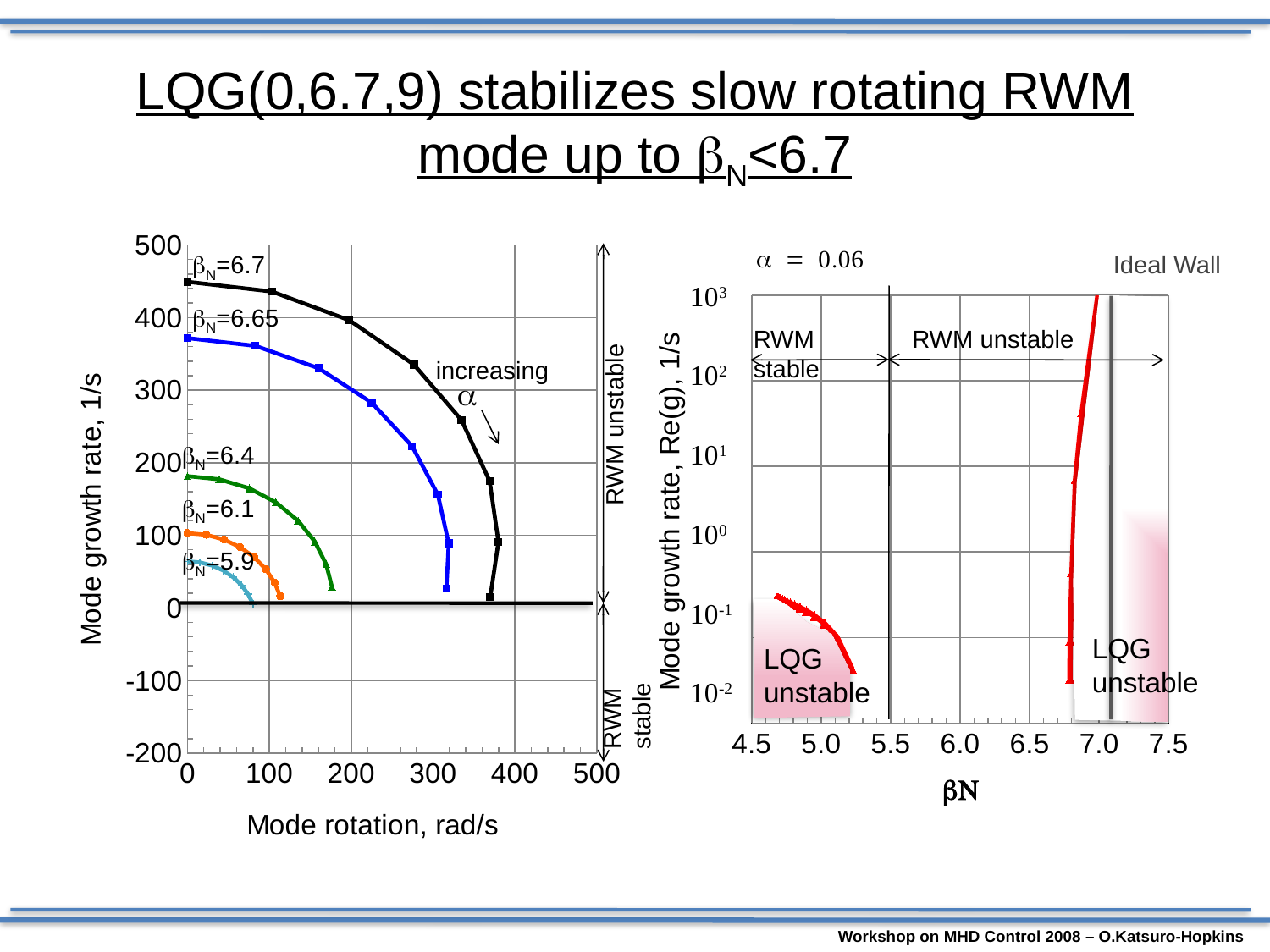
In the right chart, at what βN value is the vertical line separating the RWM stable and RWM unstable regions drawn? 5.5 In the left chart, which βN curve has the lowest growth rate at zero mode rotation? βN=5.9 In the right chart, what value of α is stated above the plot? α = 0.06 In the left chart, is the growth rate of the βN=5.9 curve at zero mode rotation greater or less than 100? less In the left chart, which βN curve has the highest growth rate at zero mode rotation? βN=6.7 In the left chart, how many βN curves are plotted? 5 In the left chart, is the growth rate of the βN=6.65 curve at zero mode rotation greater or less than 400? less In the left chart, which curve reaches a higher growth rate at zero rotation, βN=6.4 or βN=6.1? βN=6.4 What kind of chart is the left chart (Mode growth rate vs Mode rotation)? line chart In the left chart, what is the label of the x axis? Mode rotation, rad/s In the left chart, is the growth rate of the βN=6.7 curve at zero mode rotation greater or less than 400? greater In the left chart, does the mode growth rate rise or fall as mode rotation increases along each curve? fall